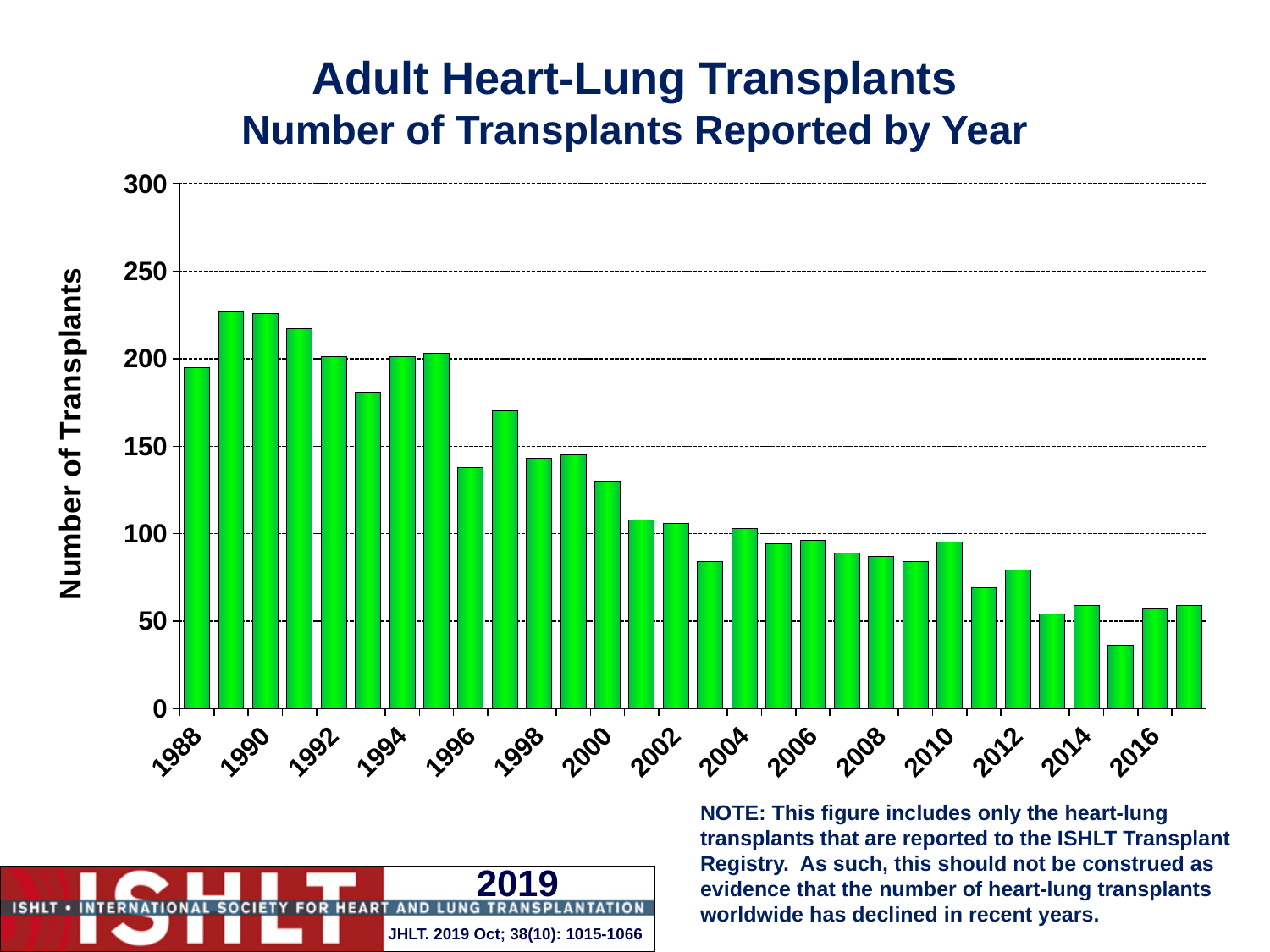
Which year has the larger number of transplants, 1988 or 2016? 1988 Is the value for 1989 greater or less than 200? greater Which year has the lowest number of transplants? 2015 Is the value for 2012 greater or less than 100? less What is the label of the vertical axis? Number of Transplants Overall, do the number of transplants rise or fall from 1988 to 2017? fall Is the value for 2000 greater or less than 100? greater What kind of chart is shown on the slide? bar chart Which year has the larger number of transplants, 1994 or 1996? 1994 How many bars (years) are plotted in the chart? 30